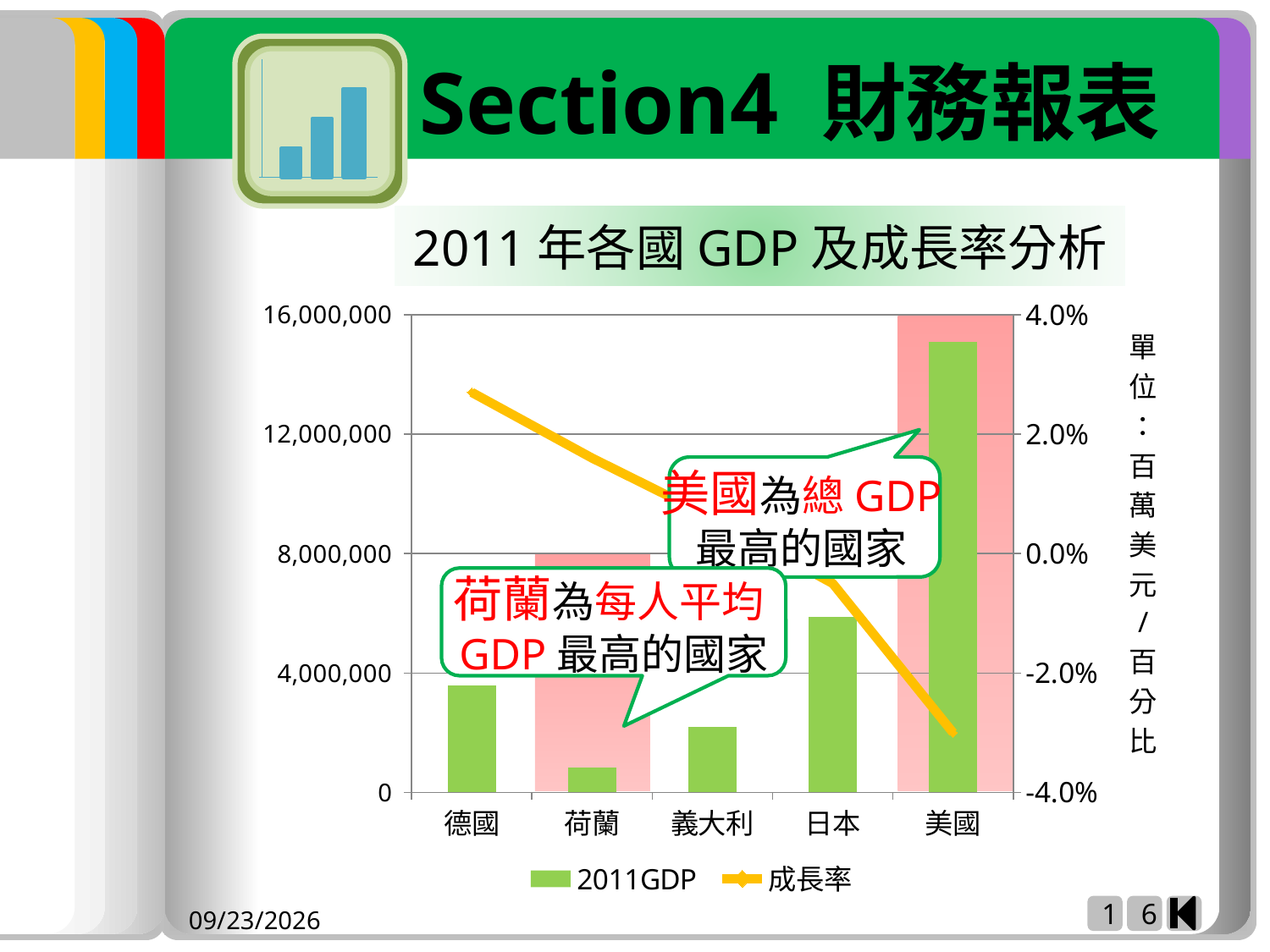
Is the 2011GDP value for 日本 greater or less than 8,000,000? less How many series does the chart legend list? 2 Which has the larger 2011GDP, 德國 or 義大利? 德國 Does the 成長率 line rise or fall from 德國 to 美國? It falls What kind of chart is shown on the slide? A combined bar and line chart Is the 2011GDP value for 美國 greater or less than 12,000,000? greater Is the 成長率 value for 美國 greater or less than -2.0%? less How many countries are shown on the x axis of the chart? 5 What is the title of the chart? 2011 年各國 GDP 及成長率分析 Which country has the highest 2011GDP bar? 美國 Which country has the lowest 2011GDP bar? 荷蘭 Which has the larger 2011GDP, 日本 or 德國? 日本